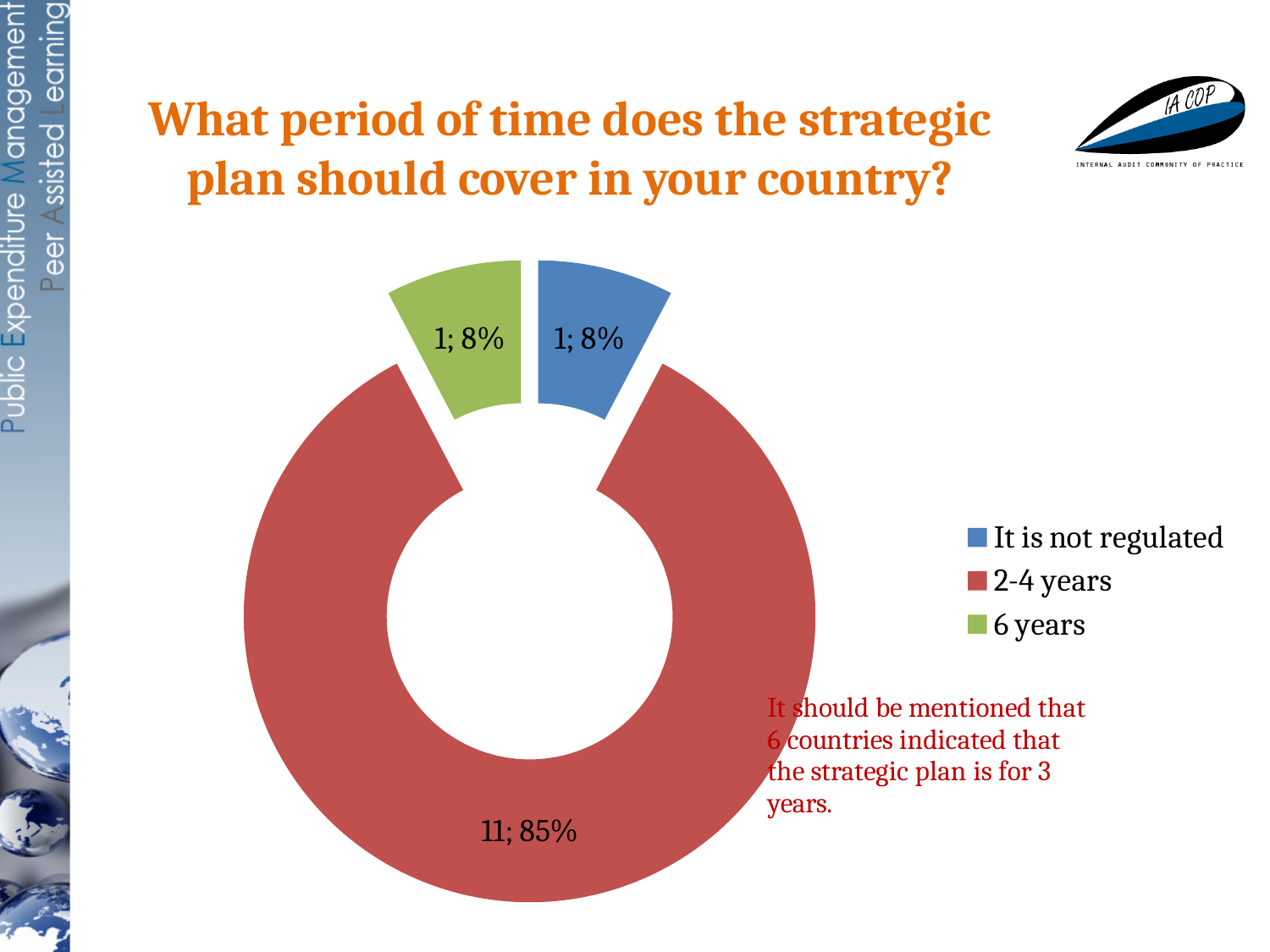
What is the difference in count between "2-4 years" and "6 years"? 10 What share of the chart does "2-4 years" represent? 85% What share of the chart does "It is not regulated" represent? 8% Which colour represents "6 years" in the chart? Green How many countries answered "2-4 years"? 11 According to the note on the slide, how many countries indicated that the strategic plan is for 3 years? 6 Which is larger, the slice for "2-4 years" or the slice for "It is not regulated"? 2-4 years How many countries answered "6 years"? 1 What kind of chart is shown on the slide? Doughnut chart How many categories does the legend list? 3 Which category has the largest slice? 2-4 years What is the total number of responses shown in the chart? 13